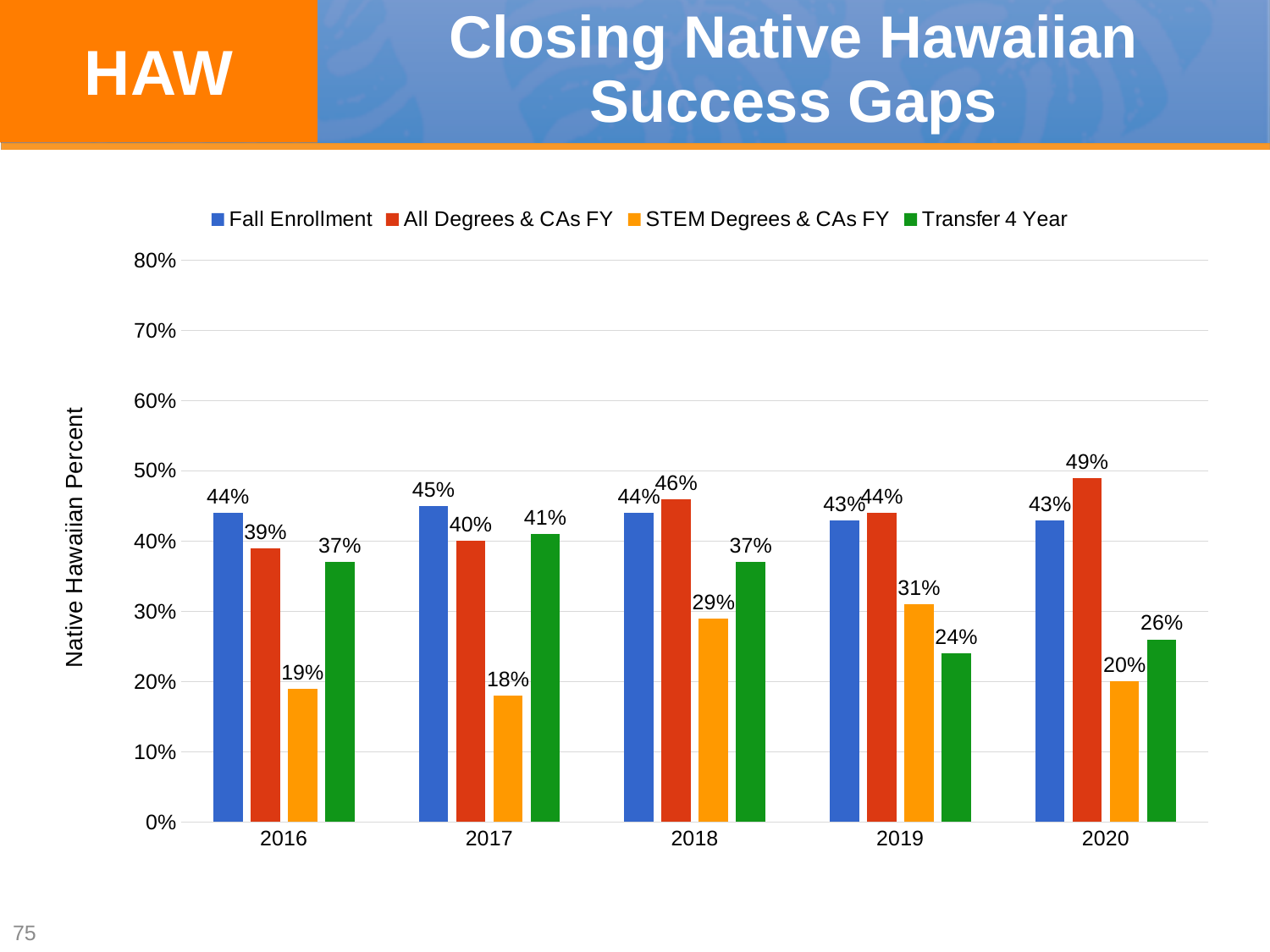
In which year is the All Degrees & CAs FY value highest? 2020 How many series does the legend list? 4 What kind of chart is shown on the slide? Bar chart Which is larger in 2017: the Transfer 4 Year value or the All Degrees & CAs FY value? Transfer 4 Year What is the STEM Degrees & CAs FY value for 2019? 31% In which year is the STEM Degrees & CAs FY value lowest? 2017 How many years are shown on the x axis? 5 What is the difference between the All Degrees & CAs FY value and the STEM Degrees & CAs FY value in 2020? 29% What is the All Degrees & CAs FY value for 2018? 46% What is the Transfer 4 Year value for 2020? 26% What is the Fall Enrollment value for 2016? 44% What is the label of the y axis? Native Hawaiian Percent